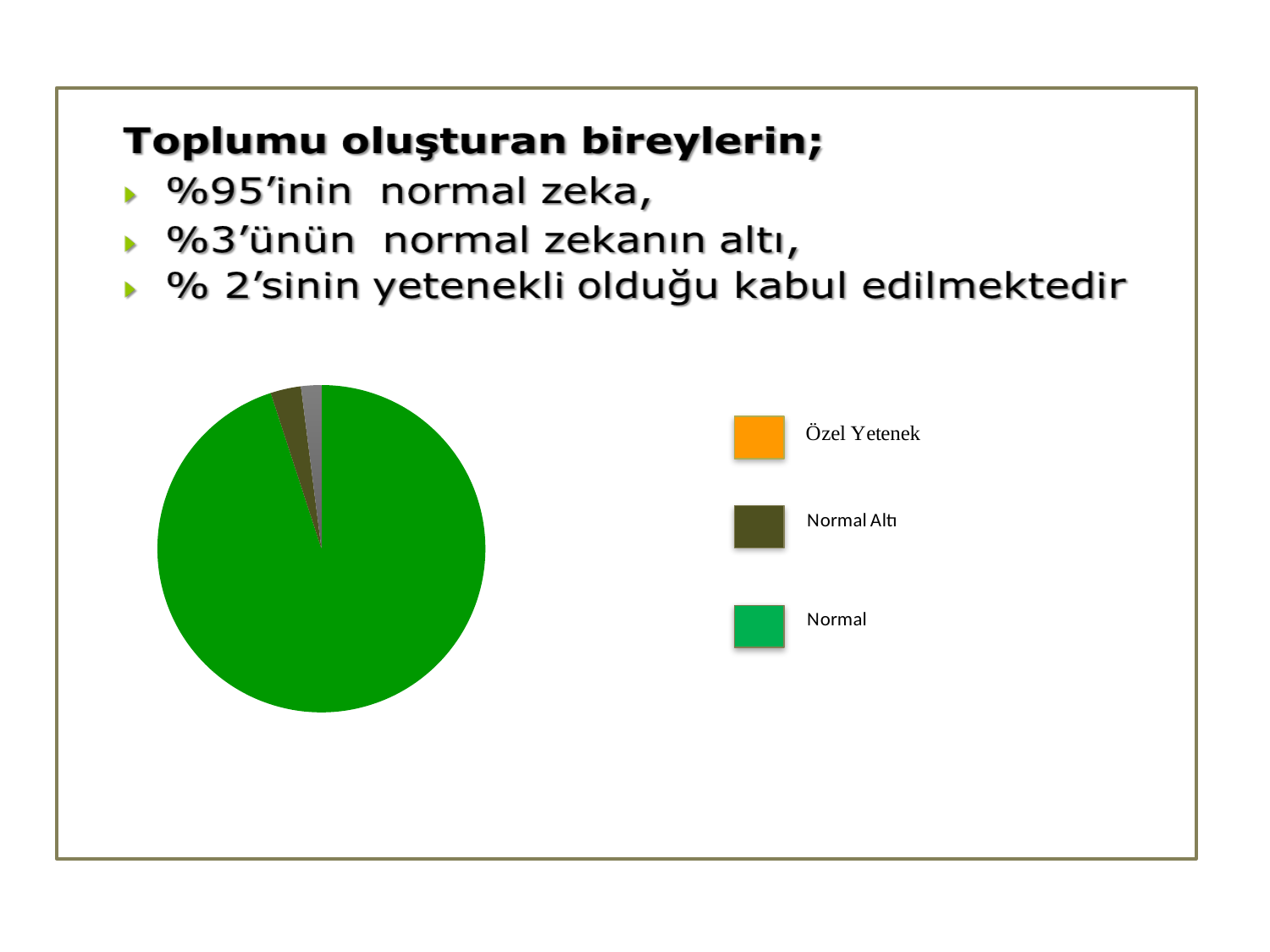
Which slice is larger in the pie chart, Normal or Normal Altı? Normal Which legend entry is listed first (at the top) in the pie chart's legend? Özel Yetenek What kind of chart is shown on the slide? pie chart Which category has the smallest slice in the pie chart? Özel Yetenek How many slices does the pie chart have? 3 Which slice is larger in the pie chart, Normal Altı or Özel Yetenek? Normal Altı How many entries does the legend of the pie chart list? 3 According to the slide, what share of the population does the Normal Altı slice represent? %3 According to the slide, what share of the population does the Normal slice represent? %95 According to the slide, what share of the population does the Özel Yetenek slice represent? %2 Which category has the largest slice in the pie chart? Normal What colour is the Normal slice in the pie chart? green